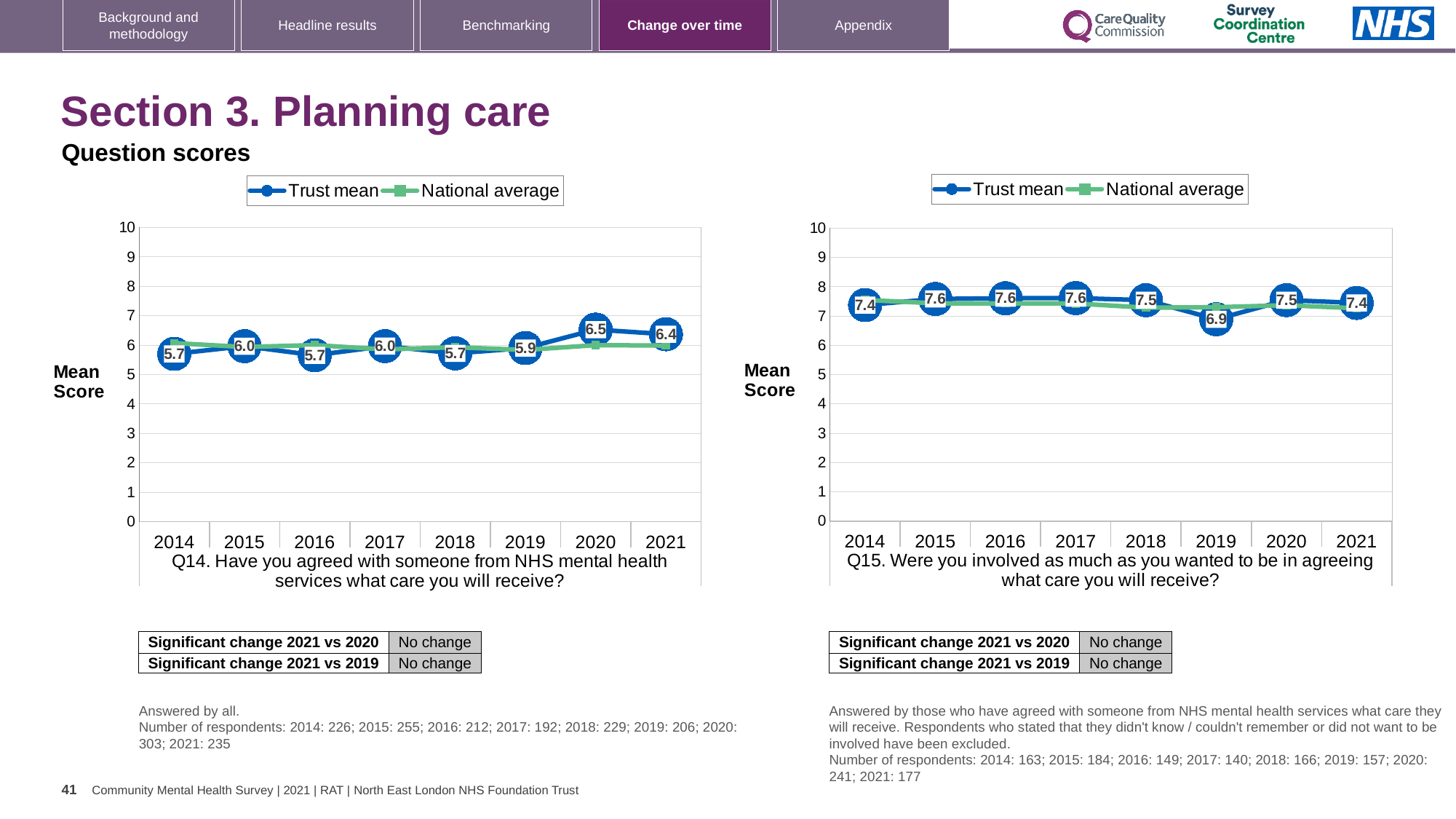
In the left chart (Q14), what is the Trust mean for 2020? 6.5 How many years are plotted on the x axis of the left chart (Q14)? 8 In the right chart (Q15), what is the Trust mean for 2019? 6.9 In the right chart (Q15), which year has the lowest Trust mean? 2019 In the left chart (Q14), which year has the highest Trust mean? 2020 In the right chart (Q15), is the Trust mean for 2019 greater or less than 7? less How many series does the legend of the right chart (Q15) list? 2 In the right chart (Q15), which is larger, the Trust mean for 2015 or for 2019? 2015 In the left chart (Q14), what is the Trust mean for 2021? 6.4 In the left chart (Q14), what is the difference between the Trust mean in 2020 and in 2019? 0.6 In the right chart (Q15), what is the Trust mean for 2021? 7.4 What kind of chart is the left chart (Q14)? Line chart